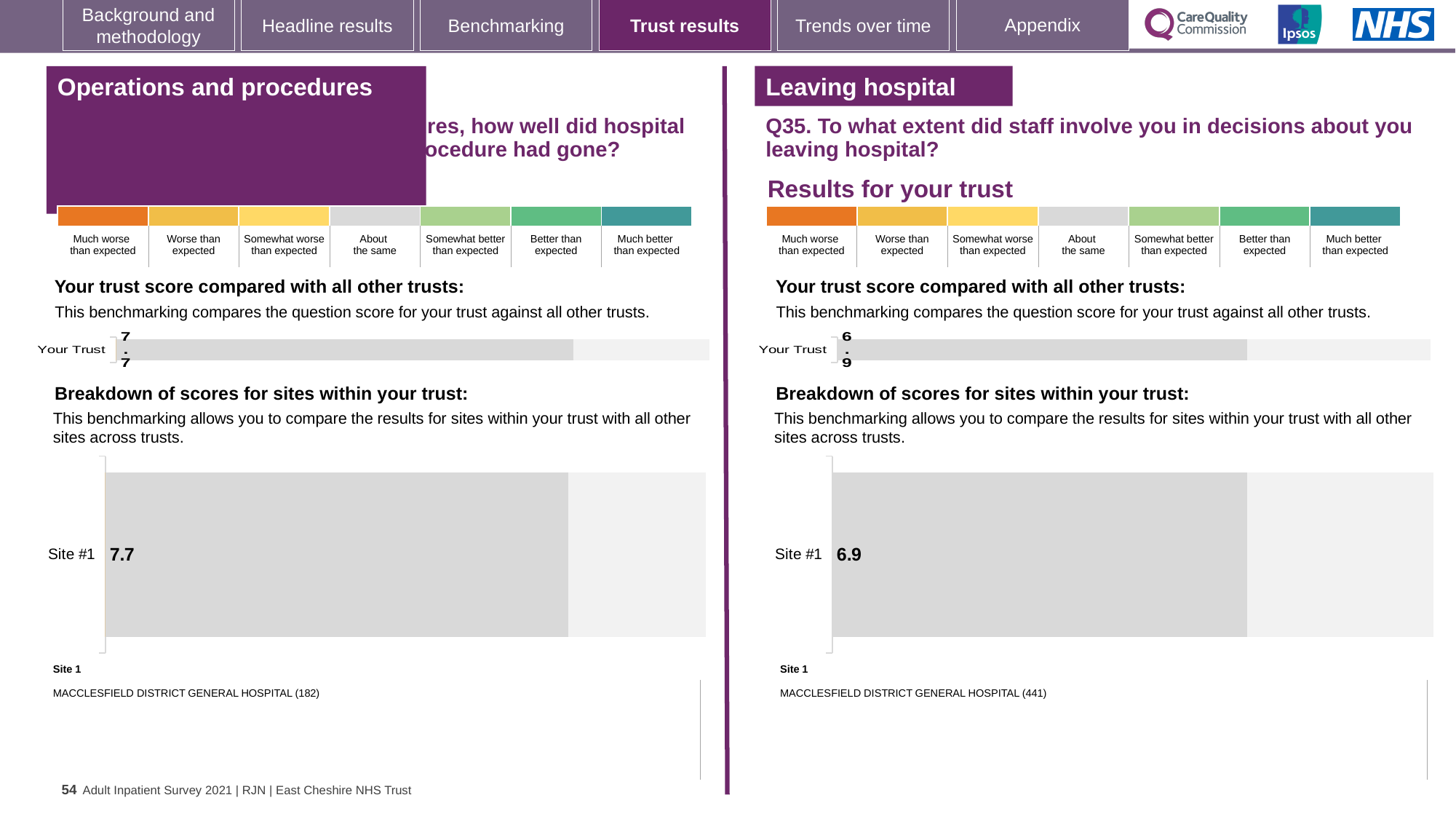
Is the Site #1 score on the Operations and procedures breakdown chart greater or less than the Site #1 score on the Leaving hospital breakdown chart? greater On the Leaving hospital breakdown of scores for sites chart, what is the score for Site #1? 6.9 Which is larger: the Your Trust score on the Operations and procedures chart or the Your Trust score on the Leaving hospital chart? Operations and procedures On the Operations and procedures breakdown of scores for sites chart, what is the score for Site #1? 7.7 On the Operations and procedures chart, what is the score shown for Your Trust? 7.7 What kind of chart is used to show the Your Trust score on the Leaving hospital side of the slide? Bar chart What number appears in parentheses after the Site 1 hospital name below the Leaving hospital breakdown chart? 441 What is the difference between the Site #1 score on the Operations and procedures chart and the Site #1 score on the Leaving hospital chart? 0.8 Which hospital is listed as Site 1 below the Leaving hospital breakdown chart? MACCLESFIELD DISTRICT GENERAL HOSPITAL How many sites are shown in the Leaving hospital breakdown of scores for sites chart? 1 On the Leaving hospital chart, what is the score shown for Your Trust? 6.9